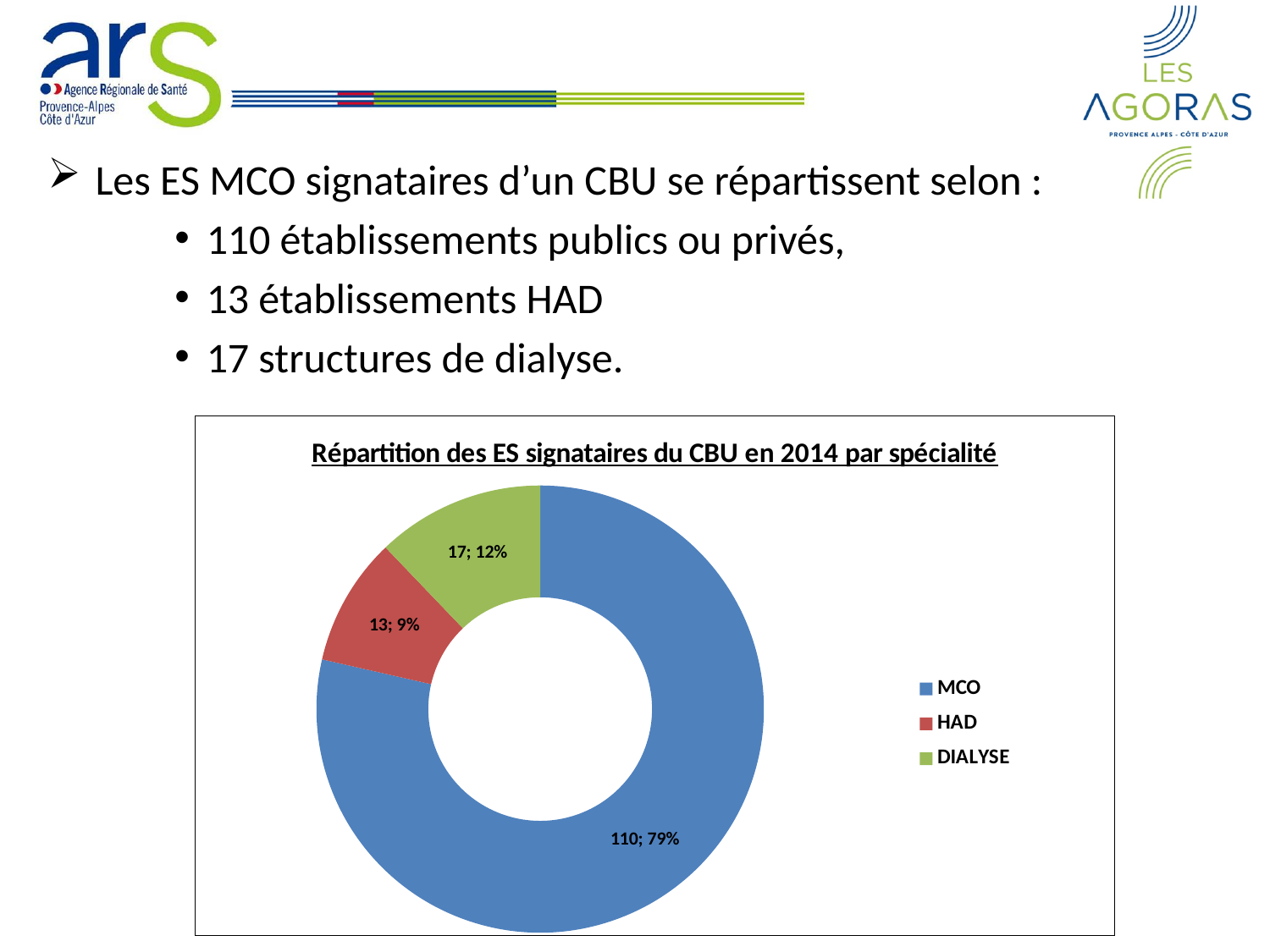
What percentage share does DIALYSE have in the chart? 12% Which category has the smallest share of the chart? HAD What is the title of the chart? Répartition des ES signataires du CBU en 2014 par spécialité Which is larger, the value for DIALYSE or the value for HAD? DIALYSE What percentage share does MCO have in the chart? 79% What is the difference between the values for MCO and HAD? 97 How many categories does the chart show? 3 What is the value for DIALYSE in the chart? 17 What kind of chart is shown on the slide? Pie chart (doughnut) Which category has the largest share of the chart? MCO What is the value for MCO in the chart? 110 What is the value for HAD in the chart? 13